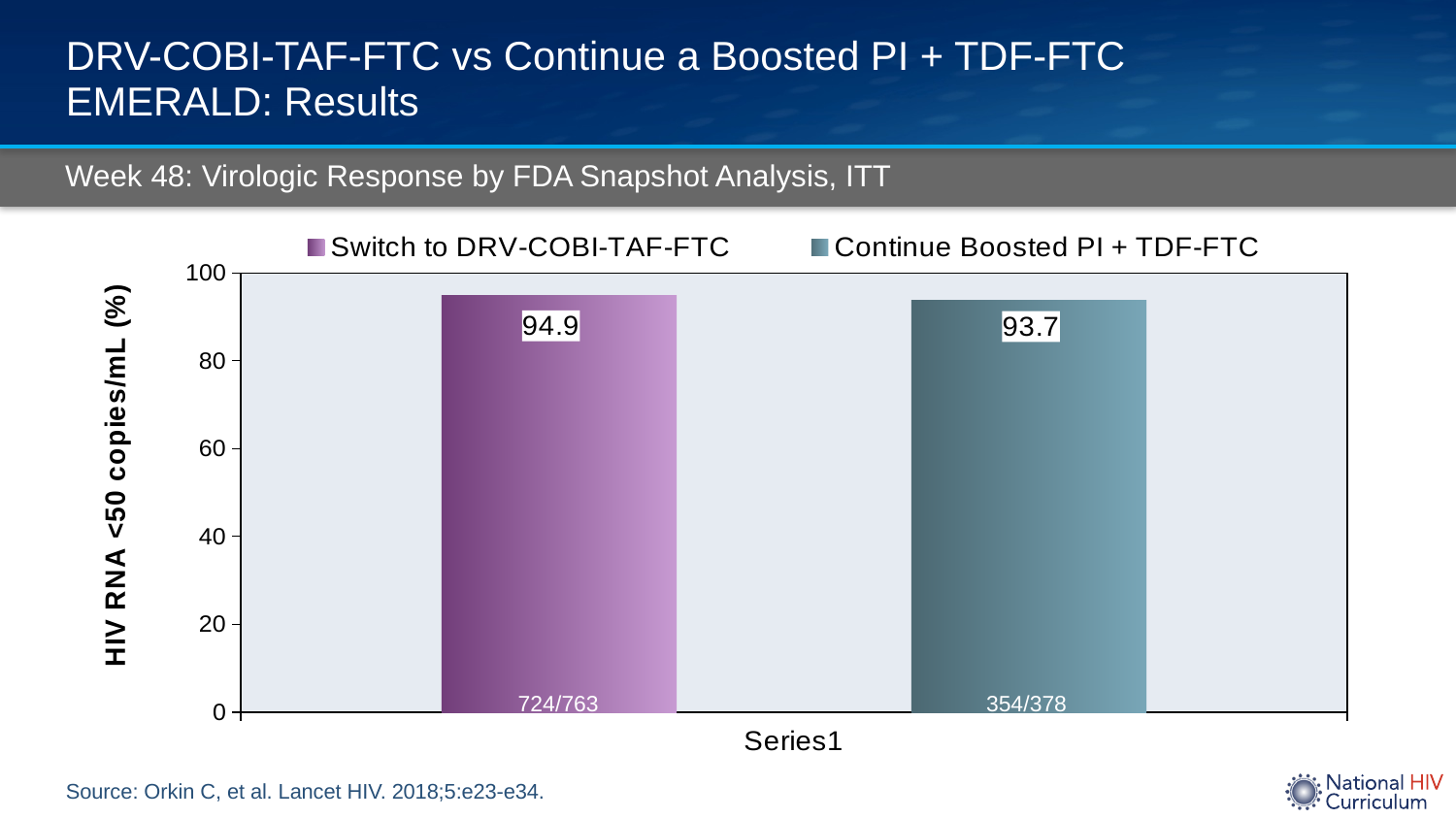
Which series has the higher value? Switch to DRV-COBI-TAF-FTC What fraction is printed at the base of the Switch to DRV-COBI-TAF-FTC bar? 724/763 How many series does the legend list? 2 What is the maximum value shown on the y-axis? 100 What is the y-axis label of the chart? HIV RNA <50 copies/mL (%) What is the value for Continue Boosted PI + TDF-FTC? 93.7 What fraction is printed at the base of the Continue Boosted PI + TDF-FTC bar? 354/378 Which series has the lower value? Continue Boosted PI + TDF-FTC What is the value for Switch to DRV-COBI-TAF-FTC? 94.9 Is the value for Continue Boosted PI + TDF-FTC greater or less than 80? greater What kind of chart is shown? bar chart What is the difference between the values for Switch to DRV-COBI-TAF-FTC and Continue Boosted PI + TDF-FTC? 1.2